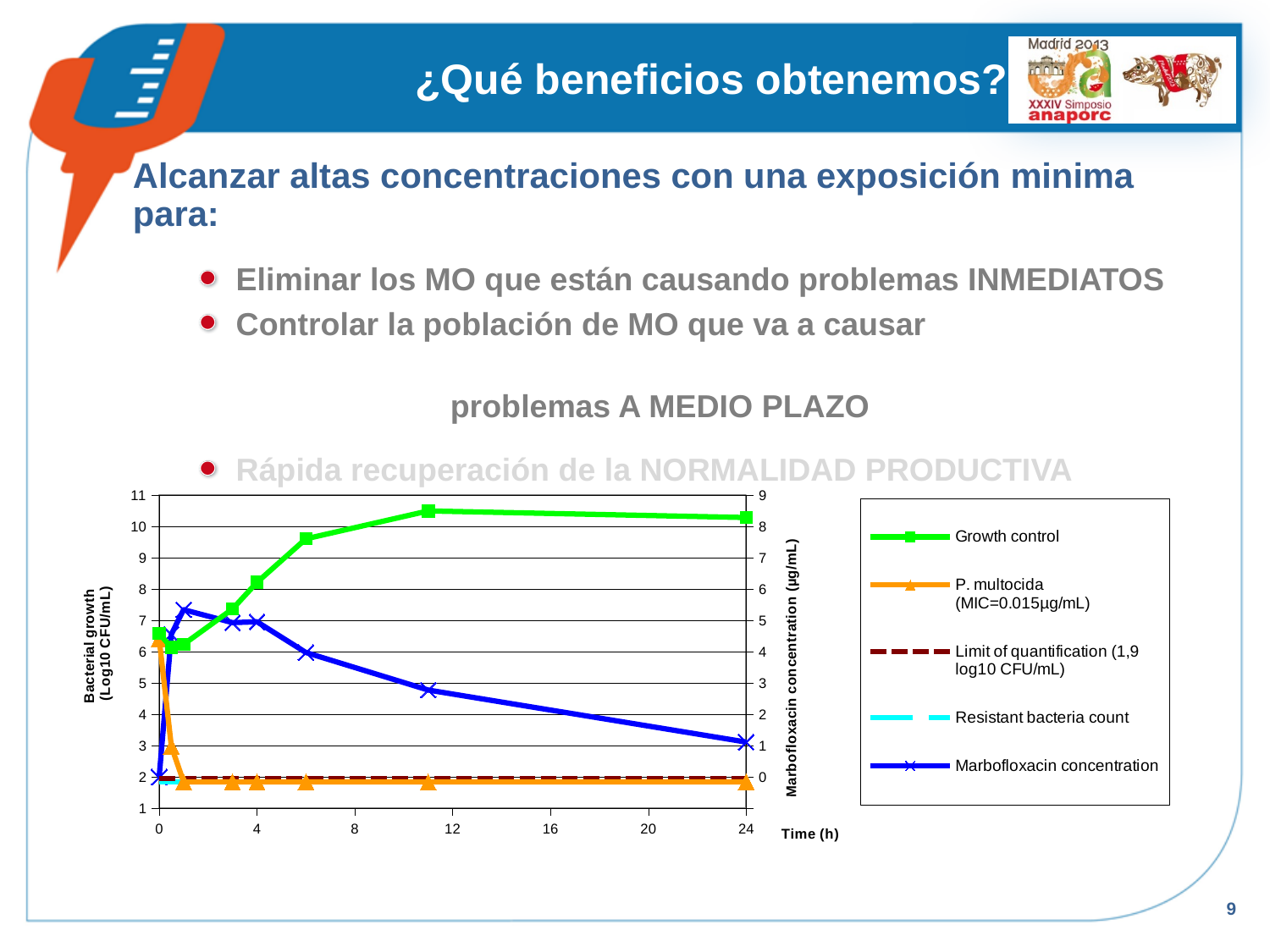
What kind of chart is shown on the slide? line chart Is the Marbofloxacin concentration at 1 h greater or less than 4 µg/mL? greater Does the Marbofloxacin concentration rise or fall between 4 h and 24 h? fall What is the title of the x axis of the chart? Time (h) How many series does the chart legend list? 5 According to the legend, what is the limit of quantification? 1,9 log10 CFU/mL At 24 h, which is larger: the Growth control value or the P. multocida value? Growth control Is the P. multocida value at 6 h greater or less than 3 log10 CFU/mL? less Does the Growth control series rise or fall between 0 h and 11 h? rise Is the Growth control value at 24 h greater or less than 9 log10 CFU/mL? greater Which series reaches the highest bacterial growth value on the chart? Growth control